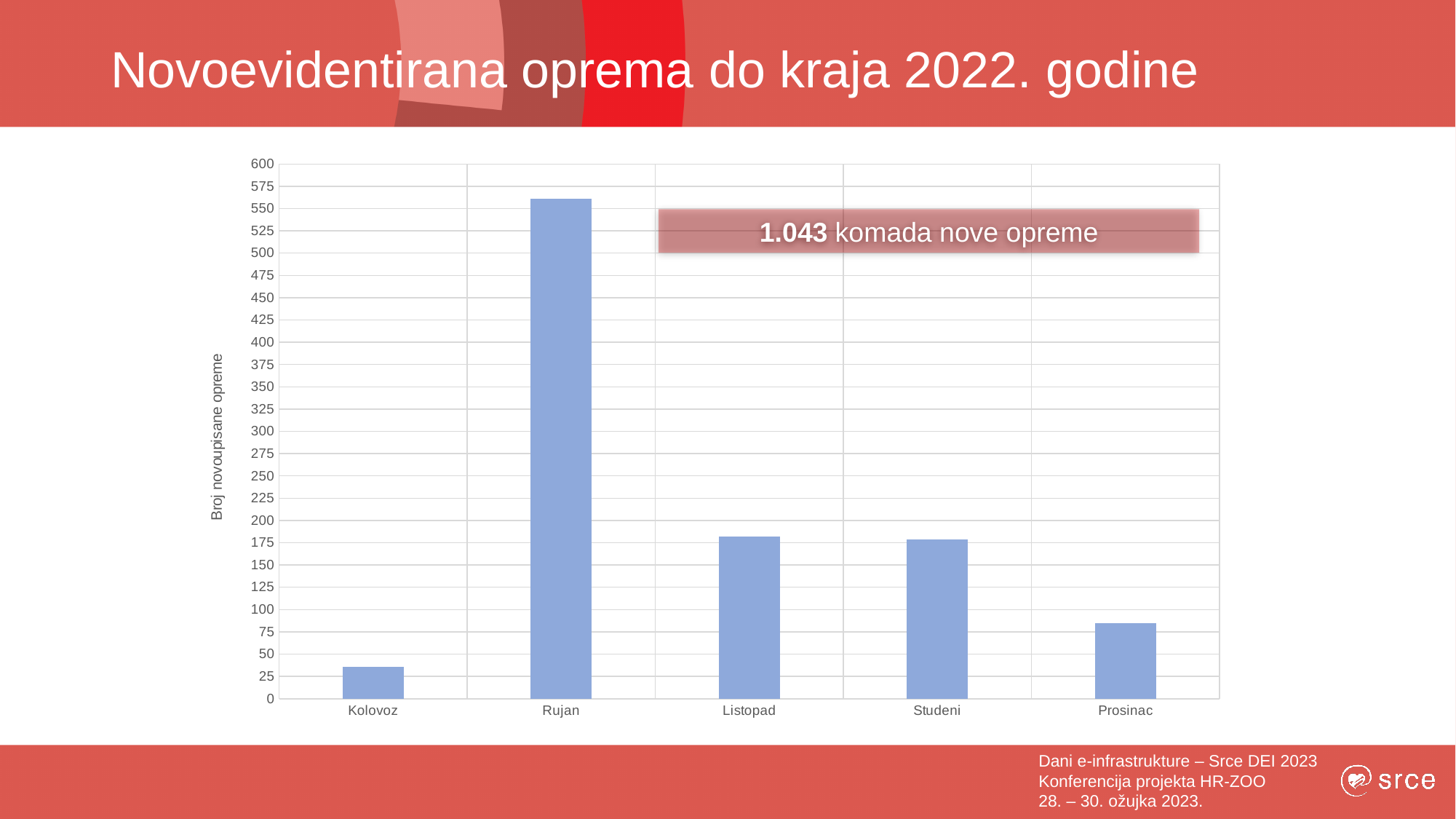
Is the value for Kolovoz greater or less than 50? less Is the value for Prosinac greater or less than 100? less How many months are shown on the x axis of the chart? 5 Which is larger, the value for Prosinac or the value for Kolovoz? Prosinac What is the label of the vertical axis of the chart? Broj novoupisane opreme Is the value for Listopad greater or less than 150? greater Which is larger, the value for Rujan or the value for Listopad? Rujan What kind of chart is shown on the slide? bar chart Which month has the lowest number of newly registered equipment? Kolovoz According to the text box on the chart, how many pieces of new equipment are there in total? 1.043 Which month has the highest number of newly registered equipment? Rujan